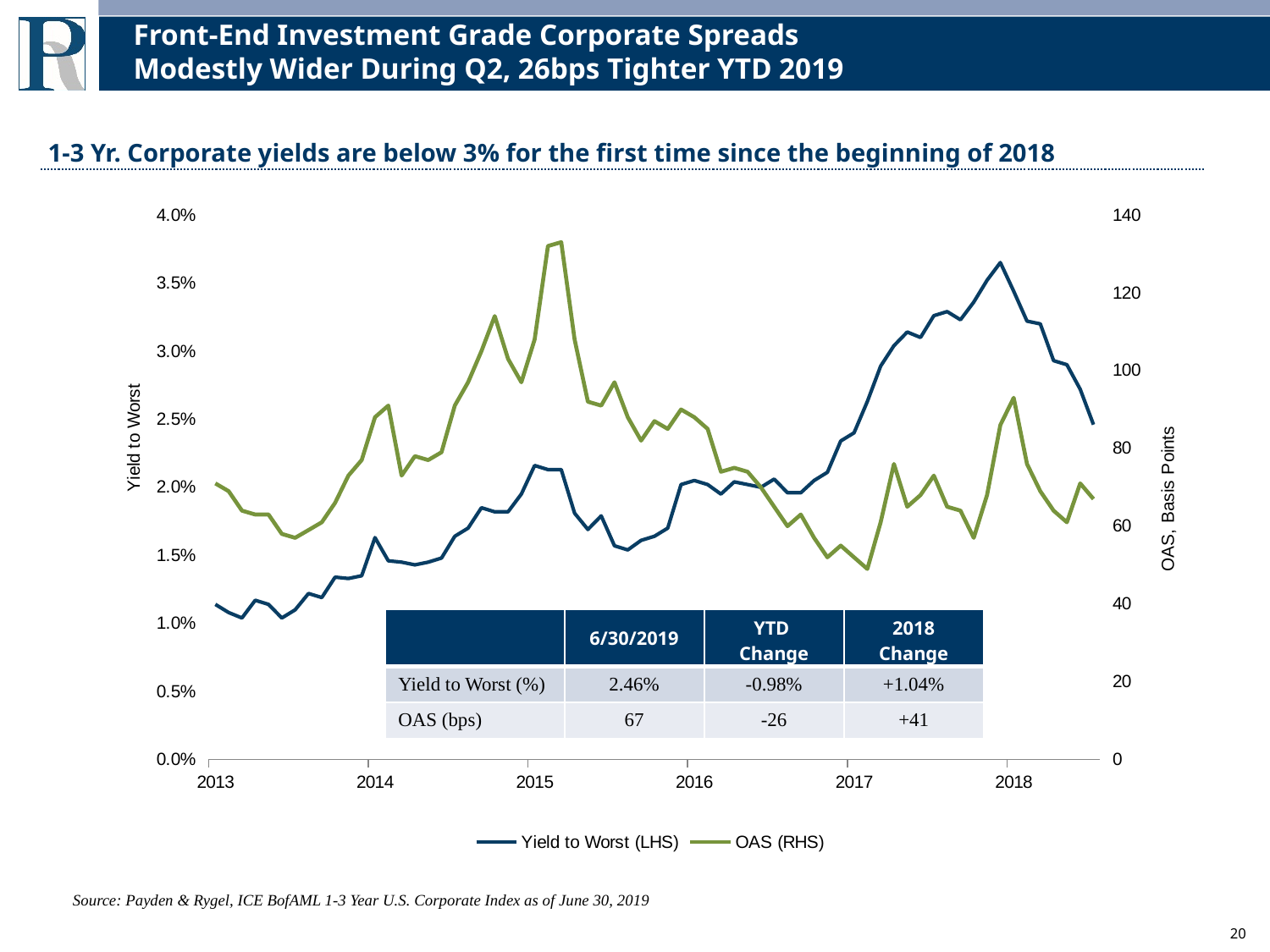
According to the table on the chart, what was the OAS in basis points on 6/30/2019? 67 Which series is plotted against the right-hand axis according to the legend? OAS (RHS) What is the 2018 change in Yield to Worst shown in the table? +1.04% Is the peak OAS value in early 2015 greater or less than 120 basis points? greater Does the Yield to Worst line generally rise or fall between 2016 and the end of 2018? rise What is the 2018 change in OAS shown in the table? +41 According to the table on the chart, what was the Yield to Worst on 6/30/2019? 2.46% What is the YTD change in Yield to Worst shown in the table? -0.98% How many series does the chart legend list? 2 What is the label of the left vertical axis? Yield to Worst What kind of chart is shown on the slide? line chart Is the Yield to Worst at the start of 2013 greater or less than 1.5%? less